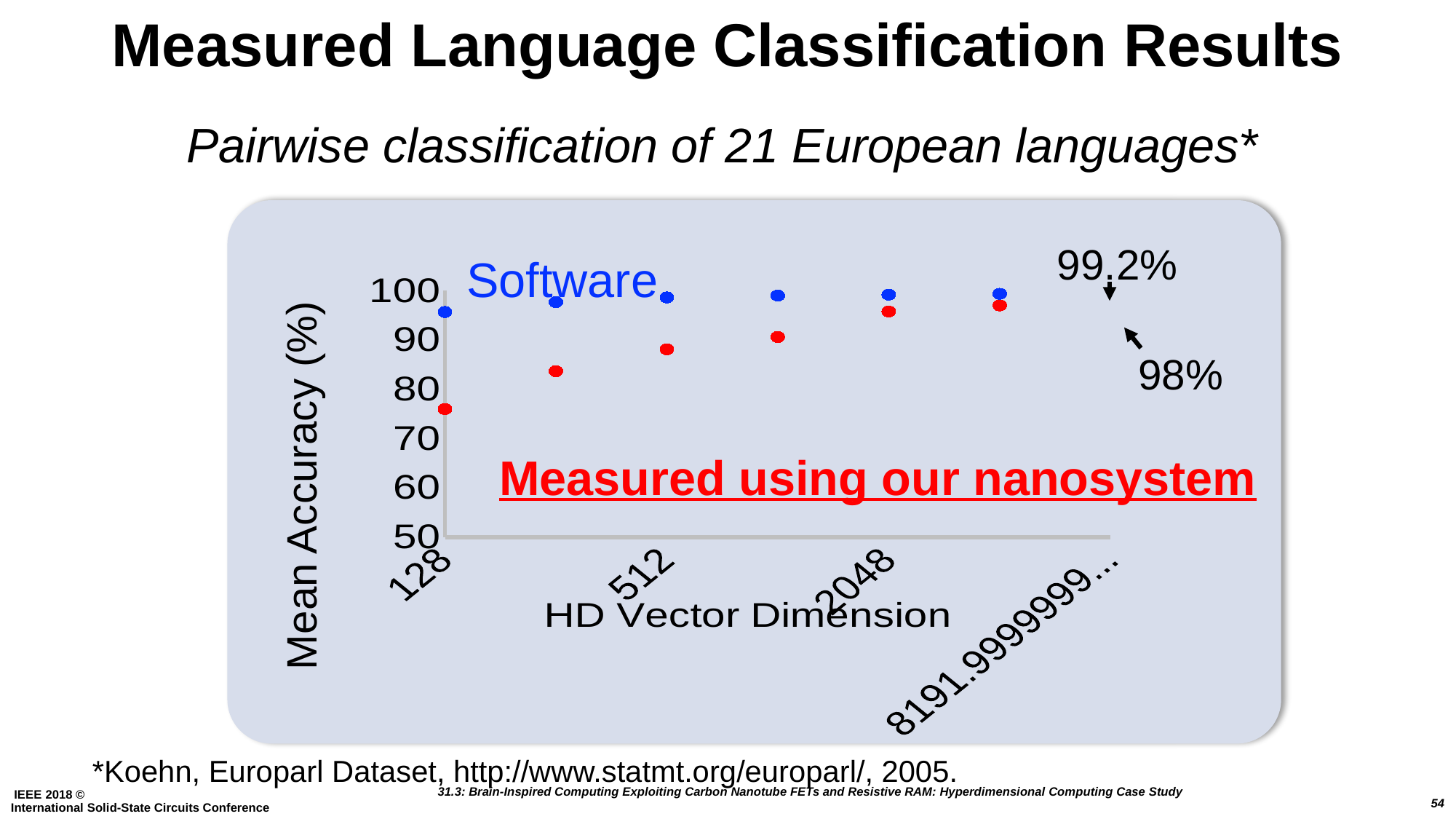
What kind of chart is shown on the slide? scatter chart What is the mean accuracy of the Software series at the highest HD vector dimension, as annotated on the chart? 99.2% How many data series are plotted on the chart? 2 At which HD vector dimension is the nanosystem's mean accuracy lowest? 128 Is the mean accuracy of the nanosystem at HD vector dimension 128 greater or less than 80? less At HD vector dimension 128, which series has the higher mean accuracy: Software or Measured using our nanosystem? Software What is the label of the y axis? Mean Accuracy (%) What is the mean accuracy measured using the nanosystem at the highest HD vector dimension, as annotated on the chart? 98% What is the difference between the annotated Software accuracy (99.2%) and the annotated nanosystem accuracy (98%) at the highest dimension? 1.2% Is the mean accuracy of the Software series at HD vector dimension 128 greater or less than 90? greater How does the mean accuracy measured using the nanosystem change as the HD vector dimension increases? It rises